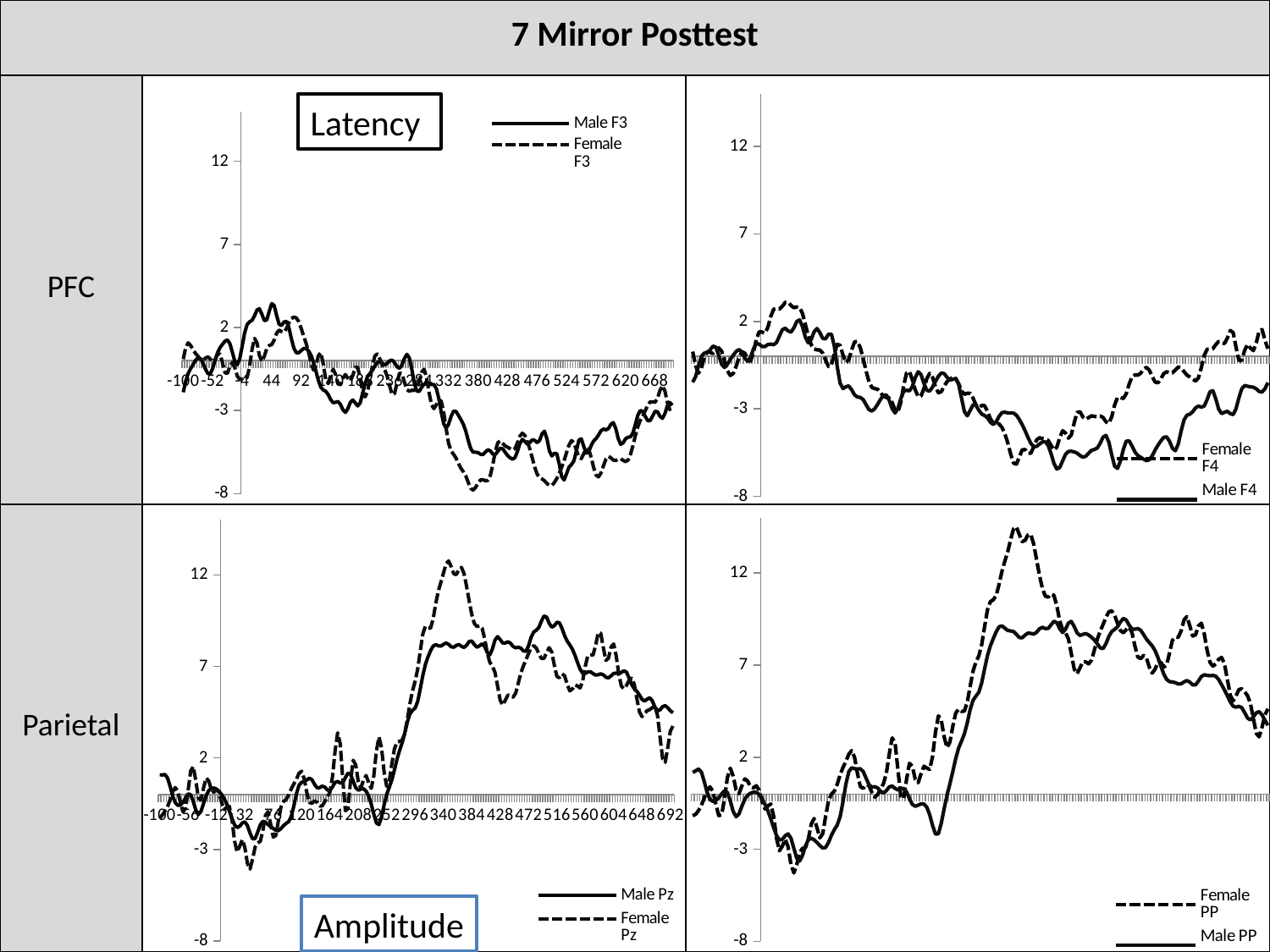
In the top-left chart (PFC), how many series does the legend list? 2 What kind of chart is shown in the top-left panel (PFC, Male F3 / Female F3)? line chart In the bottom-right chart (Parietal, Female PP / Male PP), is the peak value of Female PP greater or less than 12? greater In the bottom-right chart (Parietal, Female PP / Male PP), which series reaches the higher peak, Female PP or Male PP? Female PP In the top-left chart (PFC, Male F3 / Female F3), is the lowest value of Male F3 greater or less than -3? less In the bottom-left chart (Parietal, Male Pz / Female Pz), is the peak value of Male Pz greater or less than 7? greater How many charts are shown on the slide? 4 In the bottom-right chart (Parietal), which two series does the legend list? Female PP and Male PP In the top-right chart (PFC, Female F4 / Male F4), do the values generally rise or fall between the start of the x axis and the middle of the x axis? fall What is the title of the slide? 7 Mirror Posttest In the bottom-left chart (Parietal, Male Pz / Female Pz), which series reaches the higher peak, Male Pz or Female Pz? Female Pz